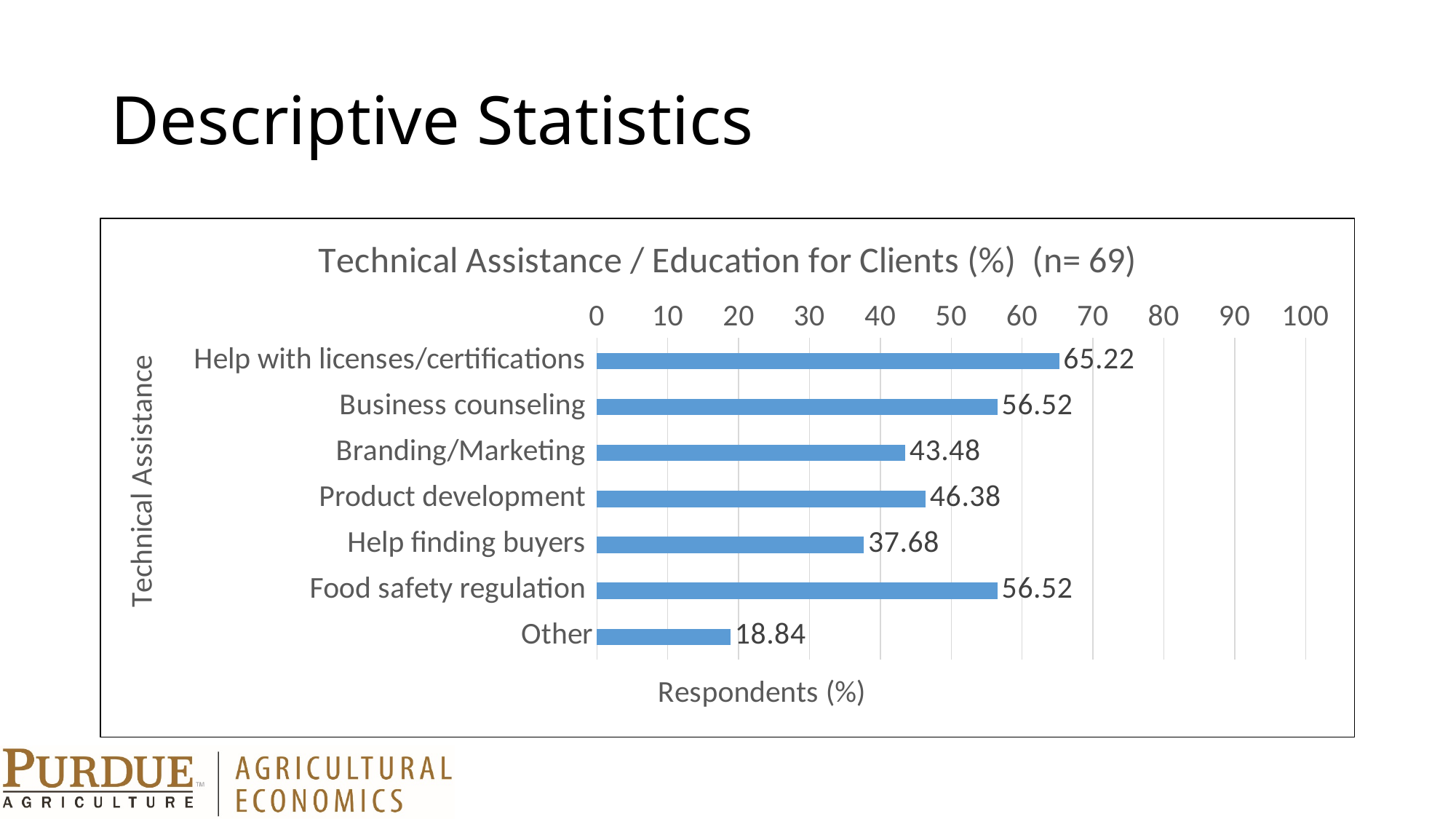
Which category has the highest value? Help with licenses/certifications What is the value for Help finding buyers? 37.68 What is the difference between the values for Help with licenses/certifications and Business counseling? 8.7 Which category has the lowest value? Other What is the title of the chart? Technical Assistance / Education for Clients (%) (n= 69) What is the value for Other? 18.84 What is the value for Product development? 46.38 Which is larger, the value for Branding/Marketing or the value for Product development? Product development Is the value for Food safety regulation greater or less than 50? greater How many categories are shown in the chart? 7 What kind of chart is shown on the slide? bar chart What is the value for Help with licenses/certifications? 65.22